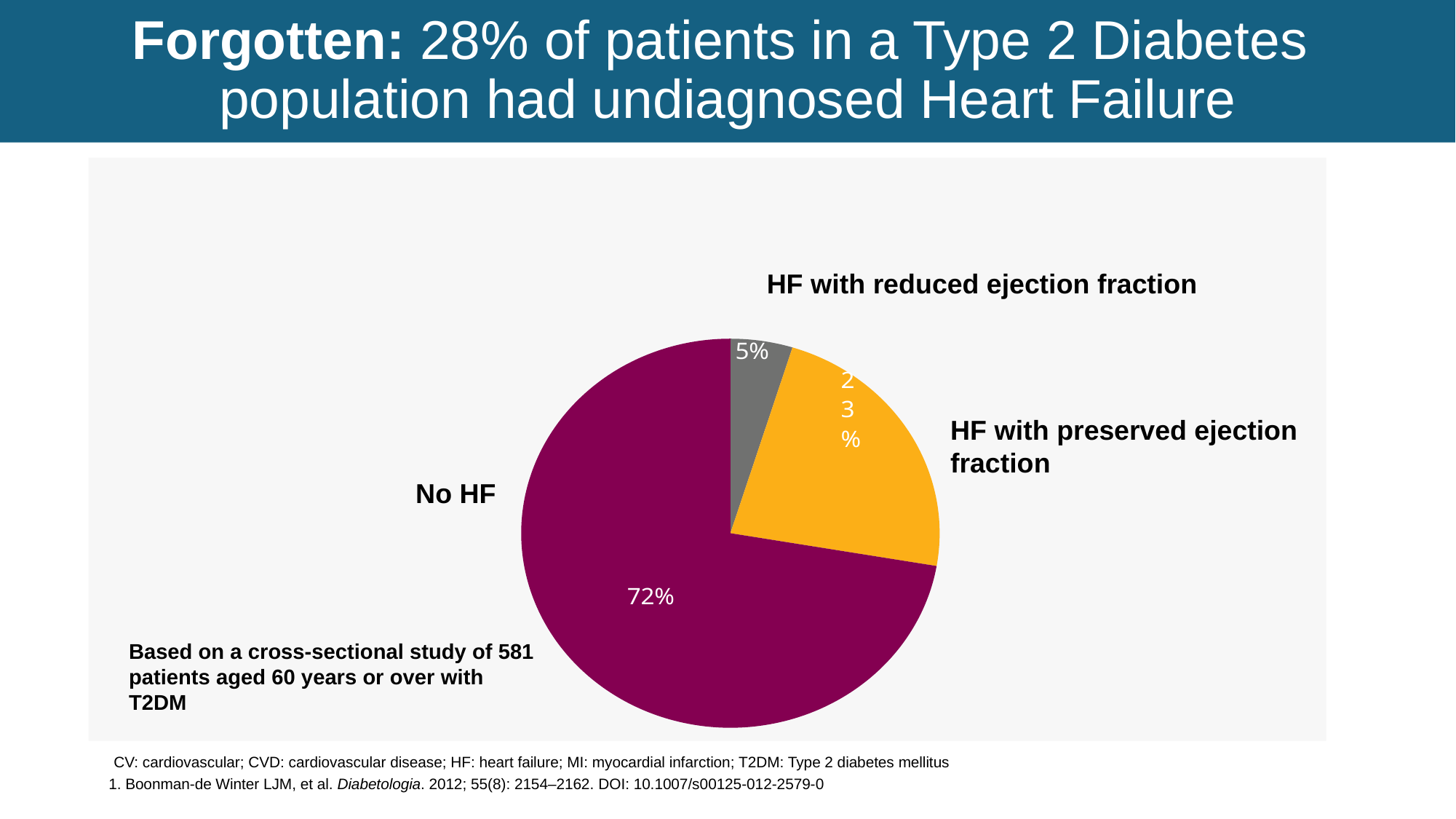
What percentage of patients had no HF? 72% What colour is the No HF slice of the pie? Purple What percentage of patients had HF with reduced ejection fraction? 5% What is the combined share of the two HF categories (reduced and preserved ejection fraction)? 28% What is the difference in percentage points between HF with preserved ejection fraction and HF with reduced ejection fraction? 18 Which category has the smallest share of the pie? HF with reduced ejection fraction What is the difference in percentage points between No HF and HF with preserved ejection fraction? 49 Which category has the largest share of the pie? No HF Which is larger: the share for HF with preserved ejection fraction or HF with reduced ejection fraction? HF with preserved ejection fraction What percentage of patients had HF with preserved ejection fraction? 23% How many slices does the pie chart have? 3 What type of chart is shown on the slide? Pie chart